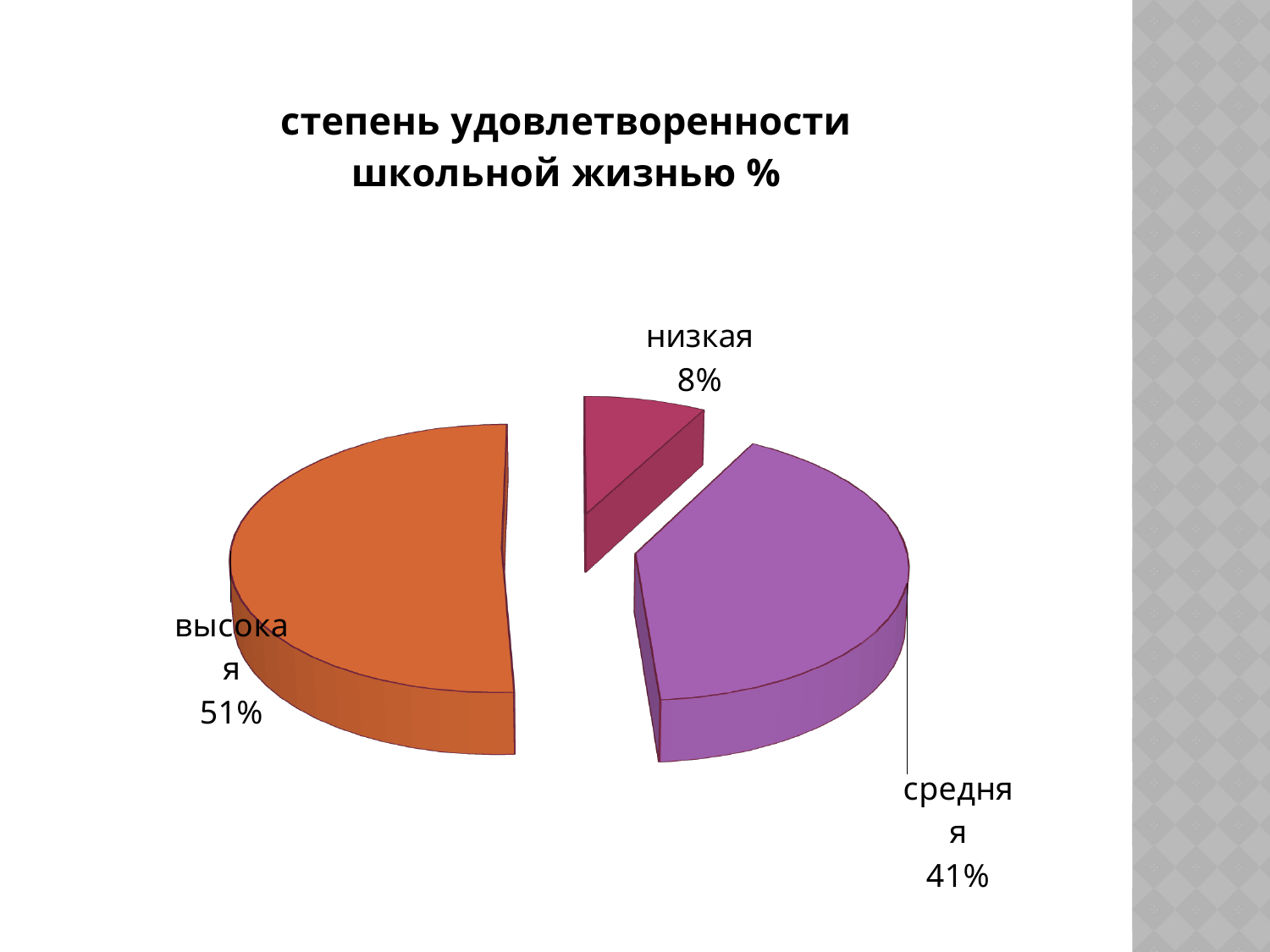
How many slices does the pie chart have? 3 What share of the pie is labelled "высокая"? 51% What kind of chart is shown on the slide? pie chart Which is larger, the share for "средняя" or the share for "низкая"? средняя What share of the pie is labelled "низкая"? 8% What is the difference in percentage points between "средняя" and "низкая"? 33 What is the title of the chart? степень удовлетворенности школьной жизнью % What is the difference in percentage points between "высокая" and "средняя"? 10 Which category has the largest slice of the pie? высокая Which category has the smallest slice of the pie? низкая What share of the pie is labelled "средняя"? 41% What colour is the slice for "высокая"? orange